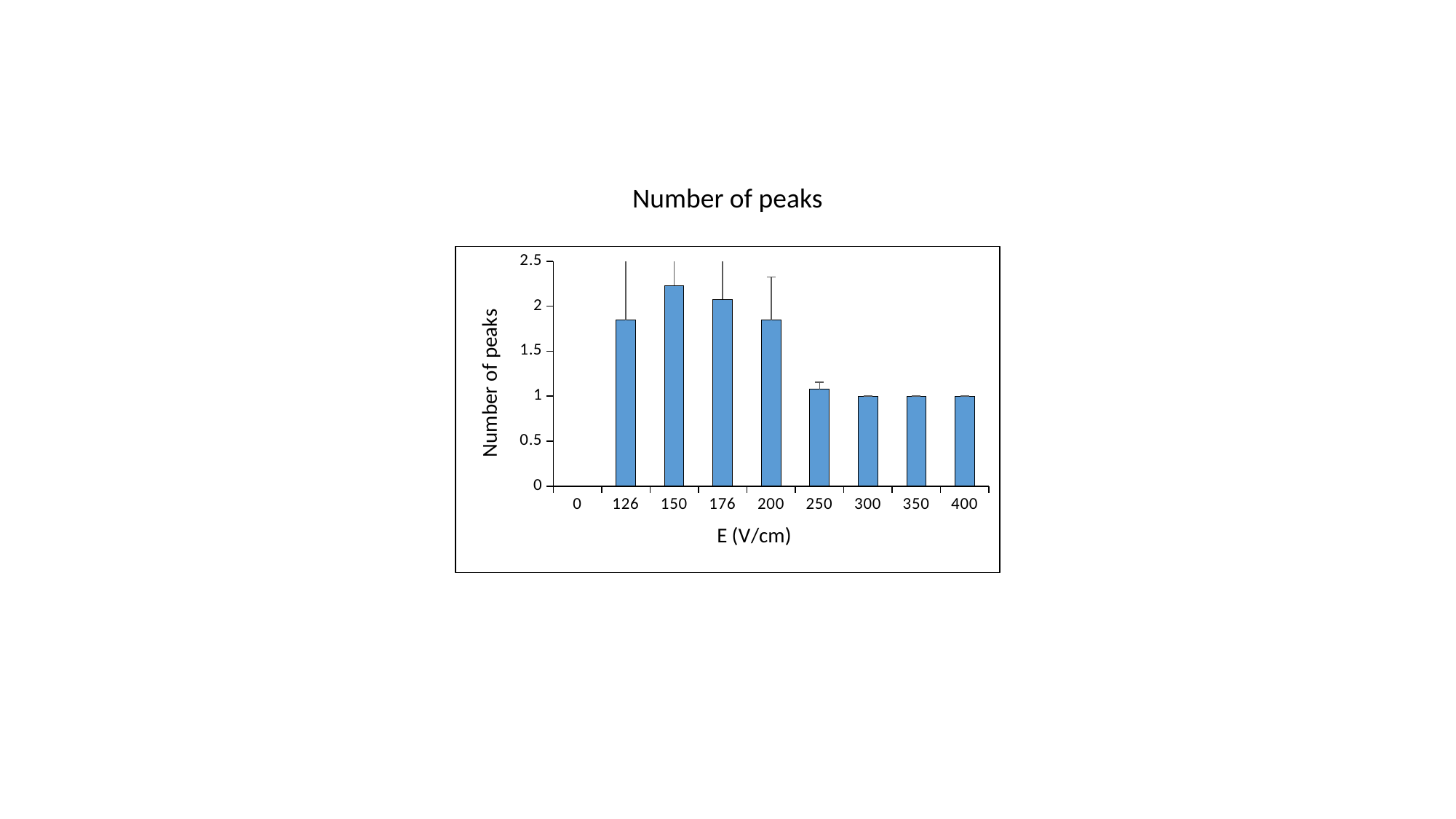
What is the title of the chart? Number of peaks Is the number of peaks at E = 150 V/cm greater or less than 2? greater What is the number of peaks at E = 300 V/cm? 1 Is the number of peaks at E = 126 V/cm greater or less than 1.5? greater How many categories are shown on the x axis? 9 Do the values rise or fall along the x axis from E = 150 V/cm to E = 400 V/cm? fall Which has a higher number of peaks, E = 150 V/cm or E = 250 V/cm? 150 What is the number of peaks at E = 400 V/cm? 1 Which E (V/cm) category has the highest number of peaks? 150 What is the label of the x axis? E (V/cm) Is the number of peaks at E = 250 V/cm greater or less than 1.5? less What kind of chart is shown on the slide? bar chart